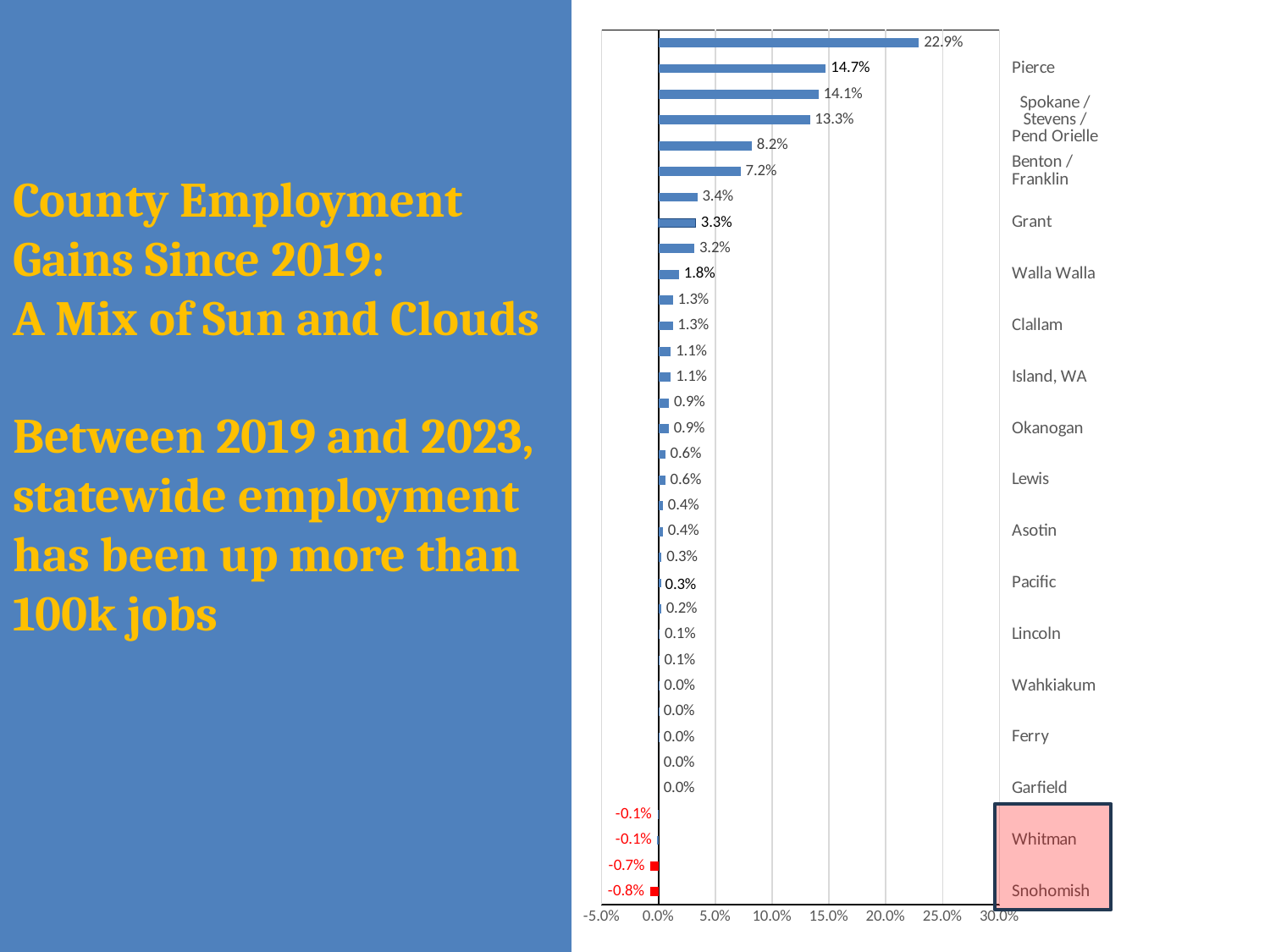
How many bars (data points) are plotted on the chart? 34 How many bars on the chart have negative values? 4 What is the highest value shown on the chart? 22.9% What is the value for Walla Walla? 1.8% What type of chart is shown on the slide? bar chart Which is larger, the value for Pierce or the value for Grant? Pierce What is the lowest value shown on the chart? -0.8% What is the maximum value shown on the horizontal axis? 30.0% What is the value for Snohomish? -0.8% What is the value for Grant? 3.3% What is the difference between the highest value (22.9%) and the second-highest value (14.7%)? 8.2% What is the value for Pierce? 14.7%